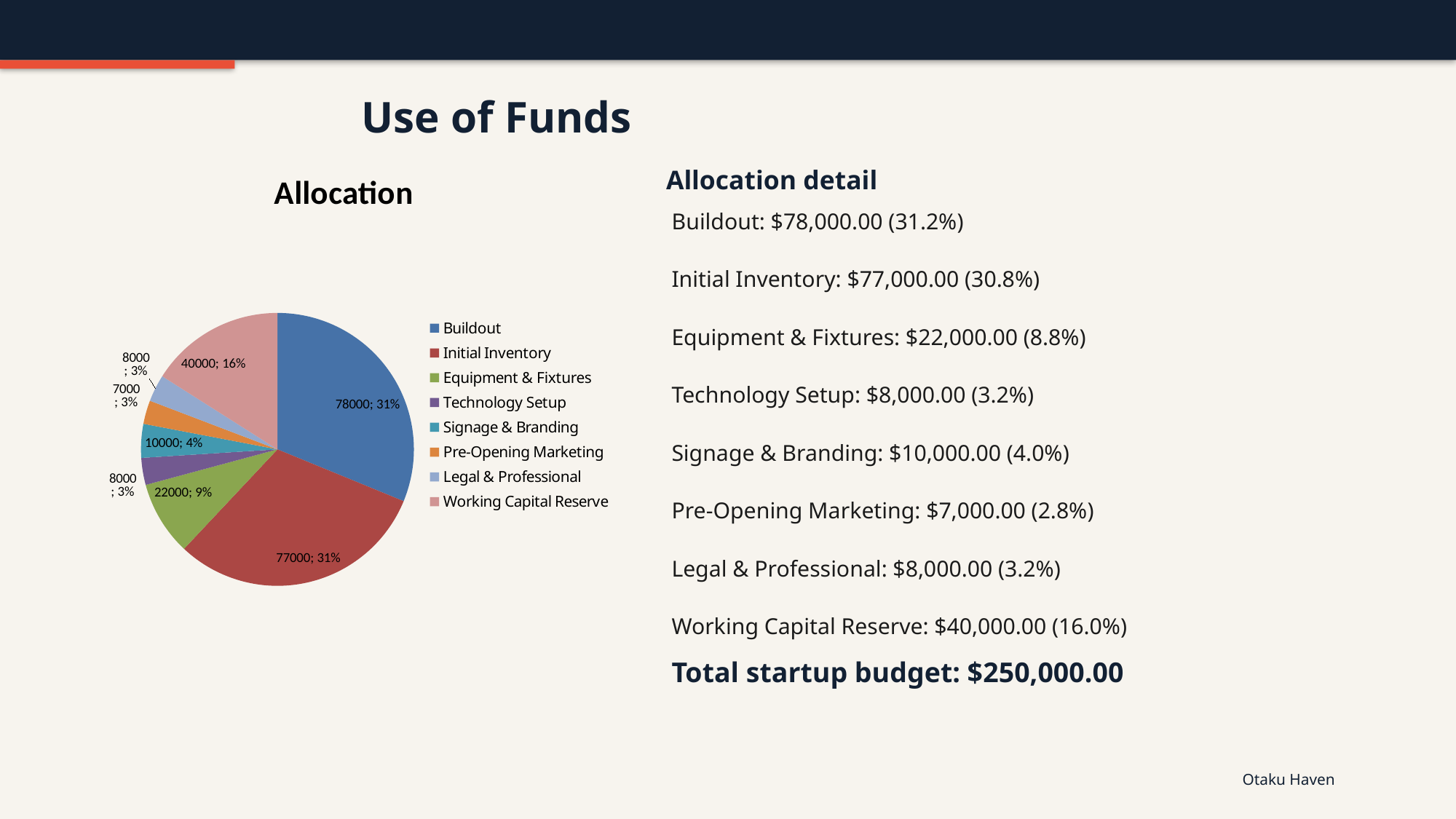
What value is shown for the Buildout slice? 78000 Which is larger, the Equipment & Fixtures slice or the Signage & Branding slice? Equipment & Fixtures What value is shown for the Signage & Branding slice? 10000 What is the title of the chart? Allocation What value is shown for the Working Capital Reserve slice? 40000 Which category has the largest slice of the pie? Buildout What share of the pie does Equipment & Fixtures represent? 9% What share of the pie does Working Capital Reserve represent? 16% How many slices does the pie chart have? 8 What is the difference between the Working Capital Reserve value and the Equipment & Fixtures value? 18000 Which category has the smallest slice of the pie? Pre-Opening Marketing What kind of chart is shown on the slide? pie chart